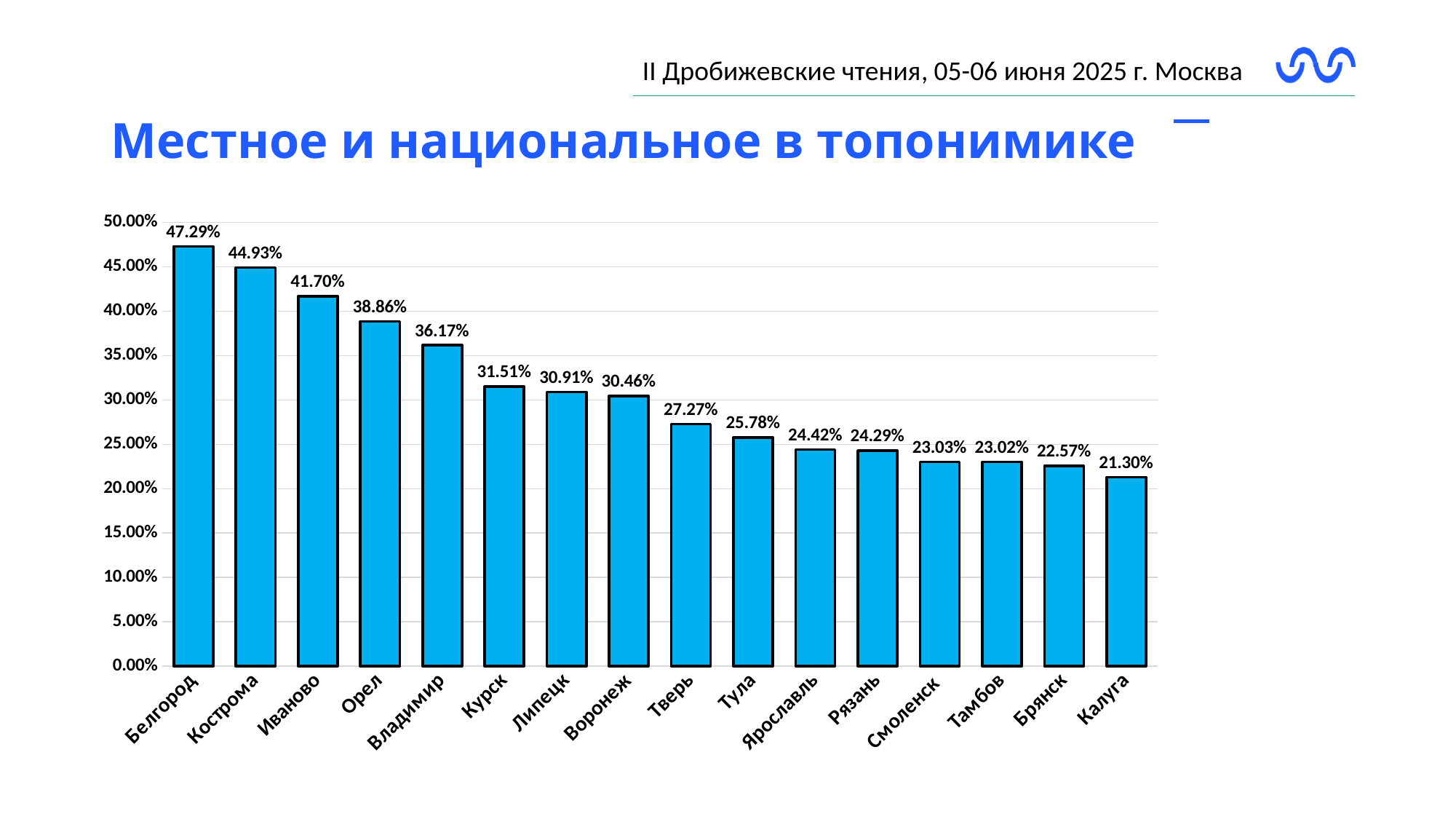
How many cities are shown on the x axis of the chart? 16 Which city has the lowest value in the chart? Калуга What is the value for Владимир? 36.17% Do the values rise or fall from left to right along the x axis? fall Which city has the highest value in the chart? Белгород Which has a larger value, Тверь or Тула? Тверь What is the difference between the values for Белгород and Калуга? 25.99% What is the value for Ярославль? 24.42% What type of chart is shown on the slide? bar chart What is the difference between the values for Кострома and Иваново? 3.23% Is the value for Орел greater or less than 35%? greater What is the value for Белгород? 47.29%